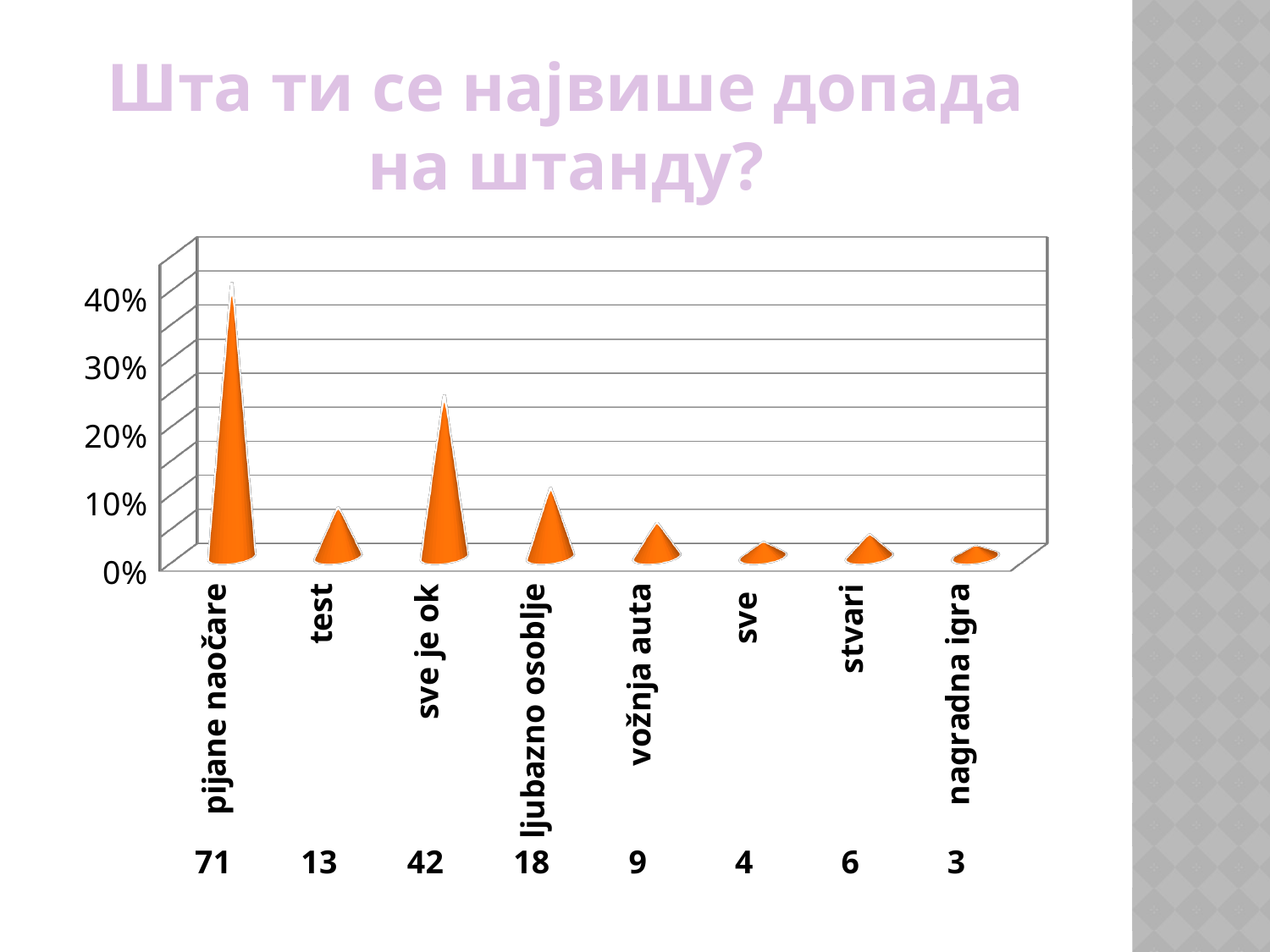
Is the value for pijane naočare greater or less than 30%? greater Which is larger, the value for test or the value for ljubazno osoblje? ljubazno osoblje Is the value for vožnja auta greater or less than 10%? less What is the difference between the numbers printed below pijane naočare and sve je ok? 29 What number is printed below the category nagradna igra? 3 Which category has the highest value in the chart? pijane naočare Which is larger, the value for pijane naočare or the value for sve je ok? pijane naočare What is the title of the chart on the slide? Шта ти се највише допада на штанду? What number is printed below the category test? 13 What kind of chart is shown on the slide? bar chart Is the value for sve je ok greater or less than 20%? greater How many categories are shown on the x axis of the chart? 8